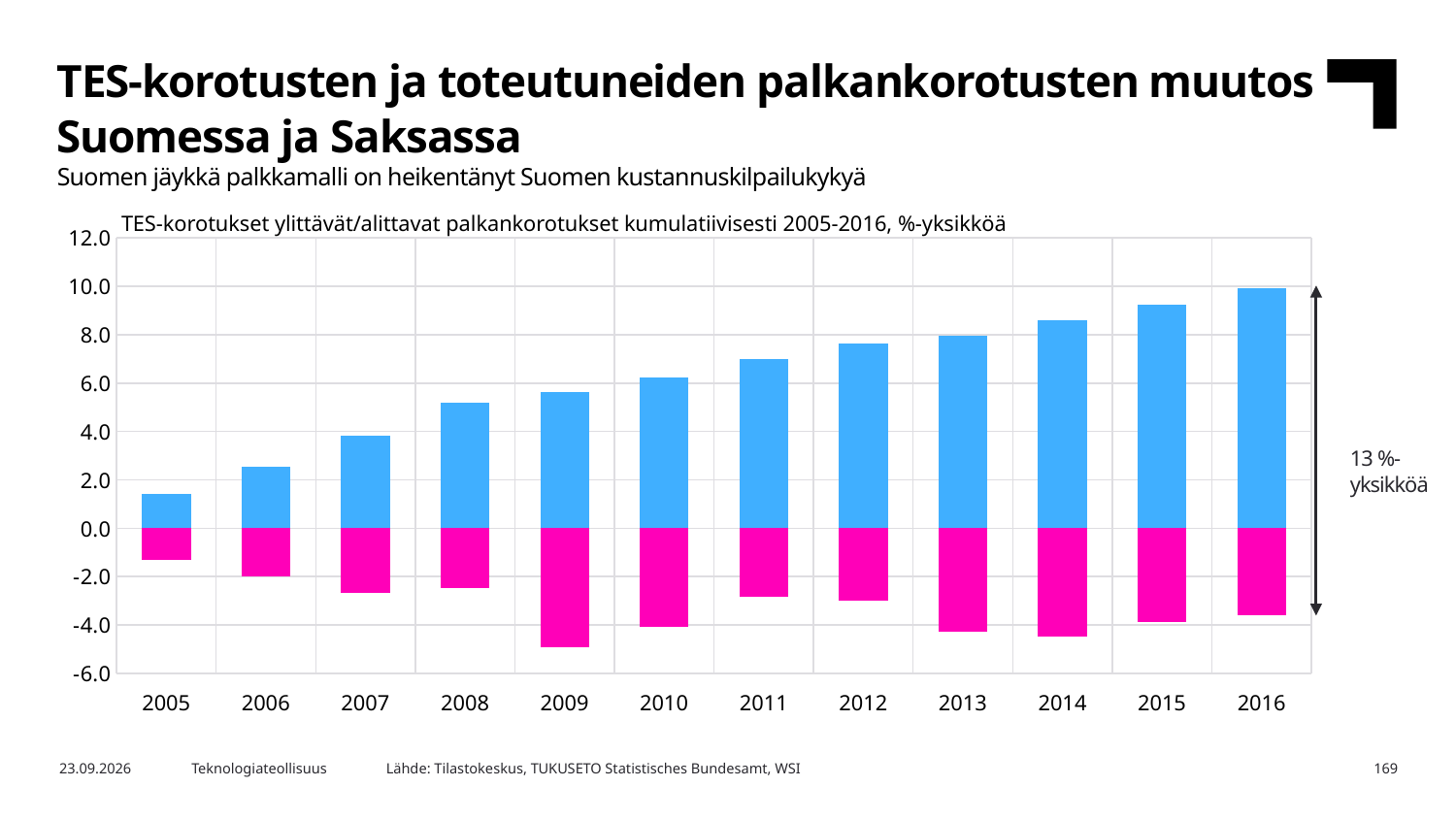
Is the blue bar for 2016 greater or less than 8.0? greater Is the blue bar for 2005 greater or less than 2.0? less Which year has a taller blue bar, 2008 or 2012? 2012 Do the blue bars rise or fall from 2005 to 2016? rise Which year has the shortest blue (positive) bar? 2005 Which year has the tallest blue (positive) bar? 2016 What kind of chart is shown on the slide? bar chart How many years are shown on the x axis of the chart? 12 Is the magenta bar for 2006 greater or less than -4.0? greater Which year has the lowest (most negative) magenta bar? 2009 What value does the annotation with the double-headed arrow on the right of the chart show? 13 %-yksikköä